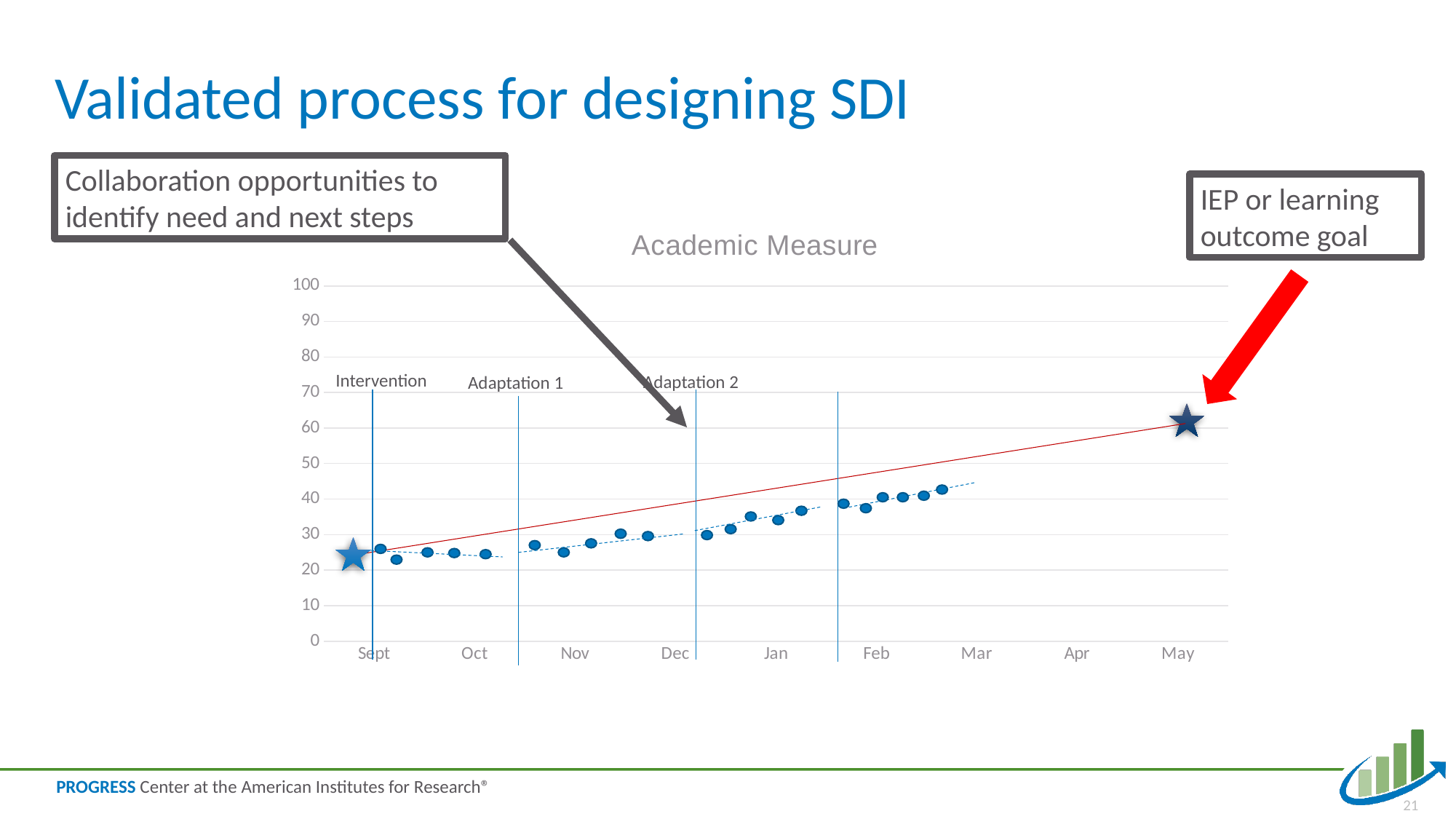
How many months are labelled on the x axis of the chart? 9 Is the last plotted data point, near Mar, greater or less than 40? greater What is the title of the chart? Academic Measure What are the three phase labels written above the vertical lines on the chart? Intervention, Adaptation 1, Adaptation 2 Which is larger: the plotted data point in Sept or the plotted data point near Mar? near Mar Do the plotted data points generally rise or fall from Sept to Mar? rise Is the lowest plotted data point greater or less than 30? less Is the last plotted data point, near Mar, greater or less than 50? less What is the highest value shown on the y axis of the chart? 100 What kind of chart is shown on the slide? scatter chart